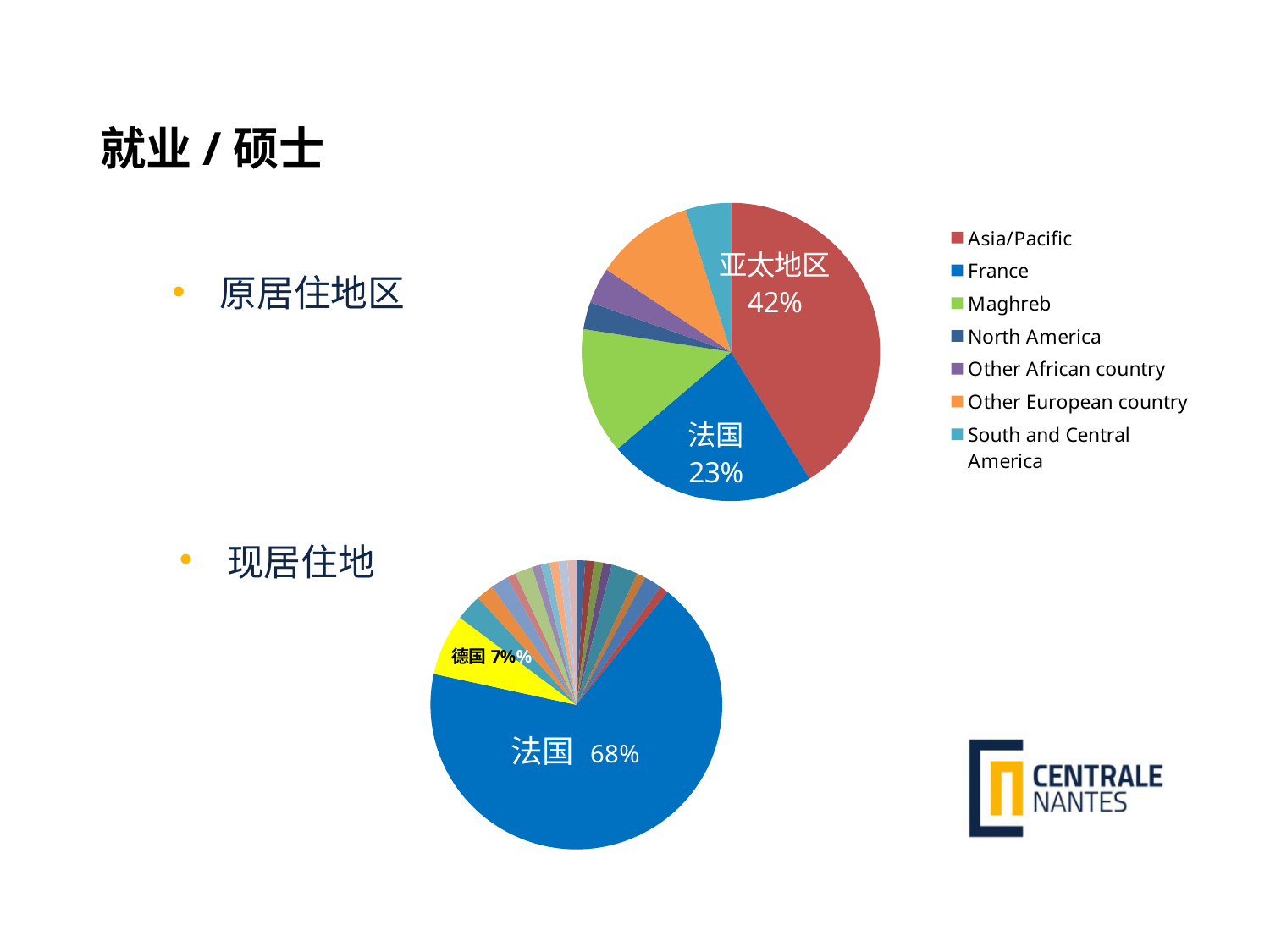
In the bottom pie chart, which category has the largest slice? 法国 (France) In the bottom pie chart, how many percentage points larger is the France share than the Germany share? 61 percentage points In the bottom pie chart, what share of the pie does France (法国) hold? 68% How many entries does the legend of the top pie chart list? 7 In the top pie chart, what colour is the Asia/Pacific slice? Red In the top pie chart, which slice is larger: France or Maghreb? France In the top pie chart, how many percentage points larger is the Asia/Pacific share than the France share? 19 percentage points In the bottom pie chart, what share of the pie does Germany (德国) hold? 7% In the top pie chart, which category has the largest slice? Asia/Pacific What kind of chart is the top chart on the slide? Pie chart In the top pie chart, what share of the pie does France (法国) hold? 23%